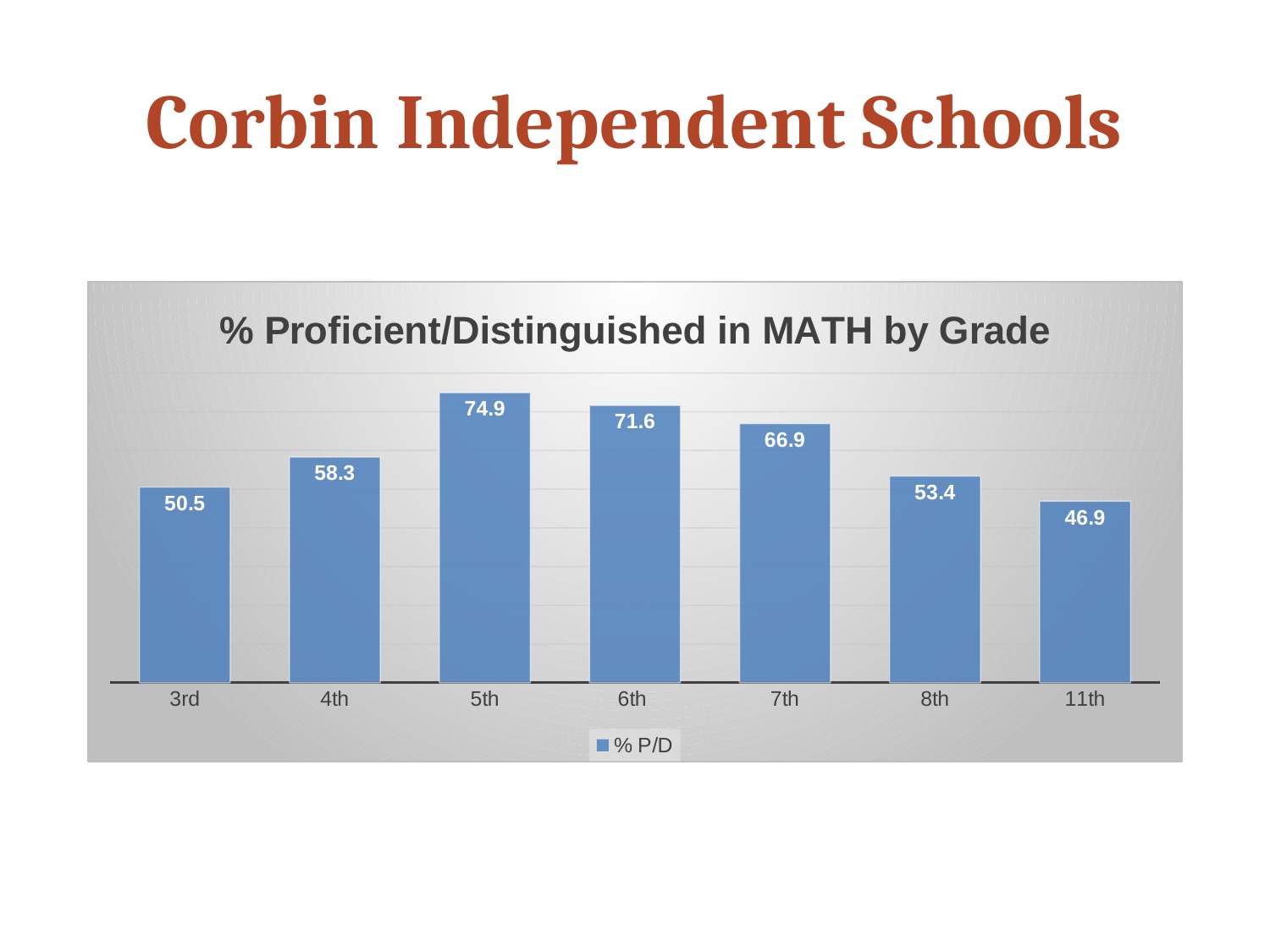
Which is larger, the value for 4th grade or the value for 8th grade? 4th What is the % P/D value for 3rd grade? 50.5 Which grade has the lowest % Proficient/Distinguished in MATH? 11th What is the difference between the 5th grade and 11th grade values? 28 What is the % P/D value for 5th grade? 74.9 How many series does the legend list? 1 Which grade has the highest % Proficient/Distinguished in MATH? 5th What is the % P/D value for 11th grade? 46.9 What kind of chart is shown on the slide? bar chart What is the difference between the 6th grade and 7th grade values? 4.7 How many grades are shown on the chart? 7 What is the title of the chart? % Proficient/Distinguished in MATH by Grade